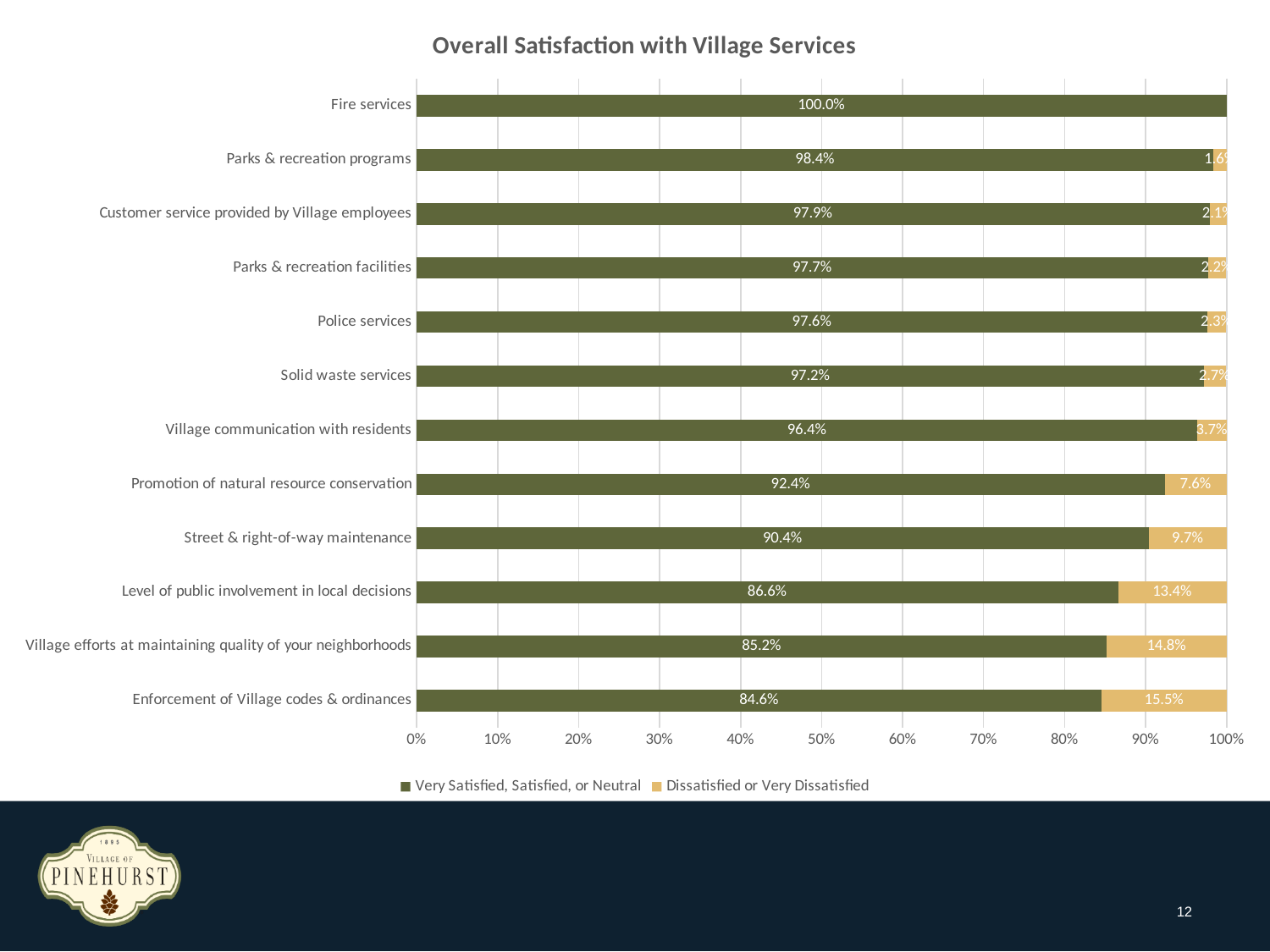
What is the 'Dissatisfied or Very Dissatisfied' value for Level of public involvement in local decisions? 13.4% What type of chart is shown on the slide? Stacked bar chart How many series does the legend list? 2 Is the 'Very Satisfied, Satisfied, or Neutral' value for Solid waste services greater or less than 90%? greater Which has a larger 'Dissatisfied or Very Dissatisfied' value: Promotion of natural resource conservation or Village efforts at maintaining quality of your neighborhoods? Village efforts at maintaining quality of your neighborhoods How many service categories are plotted on the chart? 12 Which category has the lowest 'Very Satisfied, Satisfied, or Neutral' value? Enforcement of Village codes & ordinances What is the 'Very Satisfied, Satisfied, or Neutral' value for Police services? 97.6% What is the 'Very Satisfied, Satisfied, or Neutral' value for Village communication with residents? 96.4% What is the difference between the 'Very Satisfied, Satisfied, or Neutral' values for Parks & recreation programs and Street & right-of-way maintenance? 8.0% What is the title of the chart? Overall Satisfaction with Village Services Which category has the highest 'Very Satisfied, Satisfied, or Neutral' value? Fire services